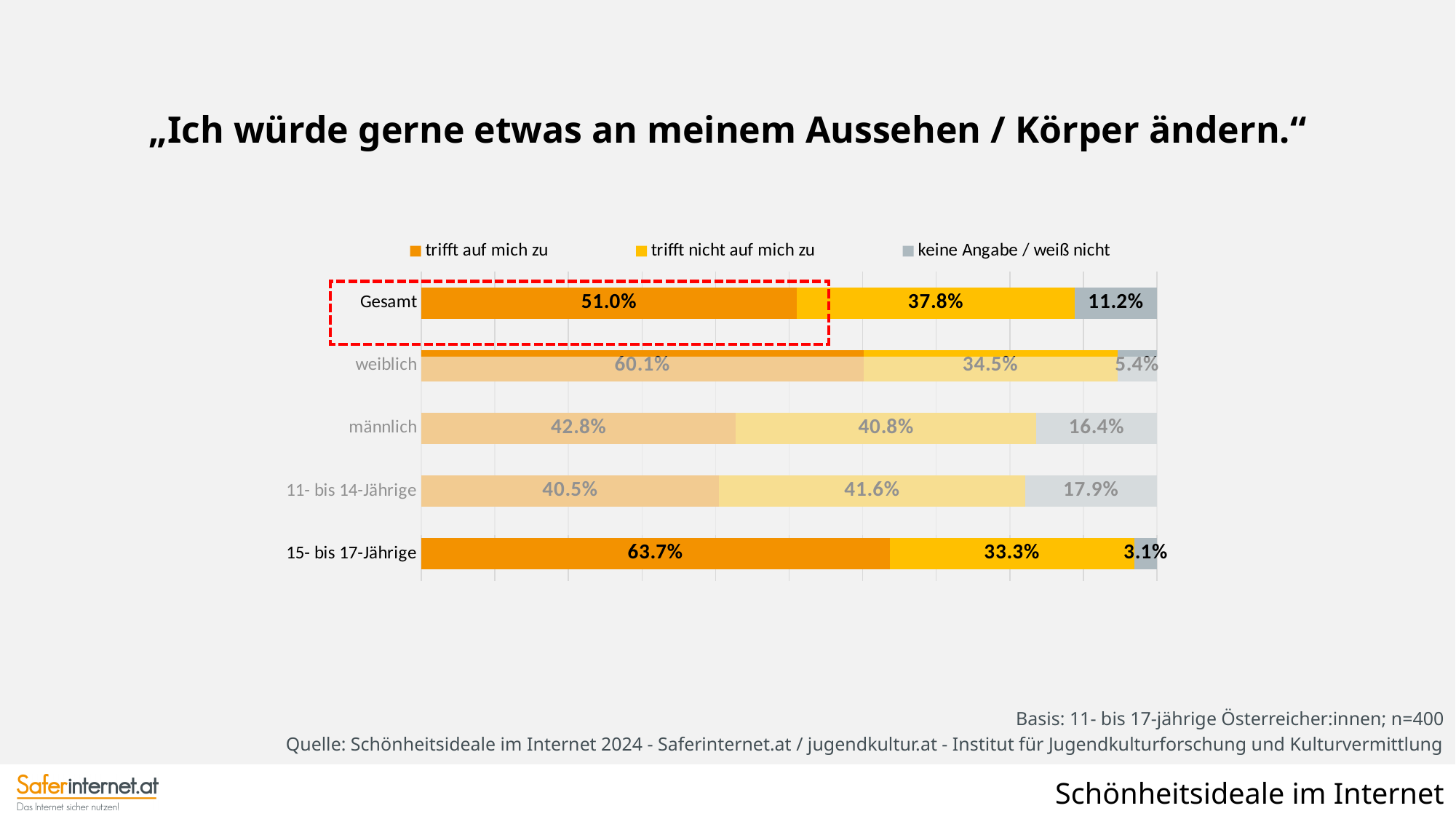
What is the difference between the "trifft auf mich zu" values for weiblich and männlich? 17.3 percentage points What is the total of the stacked bar for Gesamt? 100.0% What percentage of the Gesamt group answered "trifft auf mich zu"? 51.0% What kind of chart is shown on the slide? Stacked bar chart What is the "trifft nicht auf mich zu" value for 11- bis 14-Jährige? 41.6% Which category has the highest "trifft auf mich zu" value? 15- bis 17-Jährige How many series does the legend list? 3 Which is larger for 11- bis 14-Jährige: "trifft auf mich zu" or "trifft nicht auf mich zu"? trifft nicht auf mich zu What is the "keine Angabe / weiß nicht" value for männlich? 16.4% Which category is highlighted with a red dashed box? Gesamt How many categories are shown on the chart? 5 Which category has the lowest "keine Angabe / weiß nicht" value? 15- bis 17-Jährige